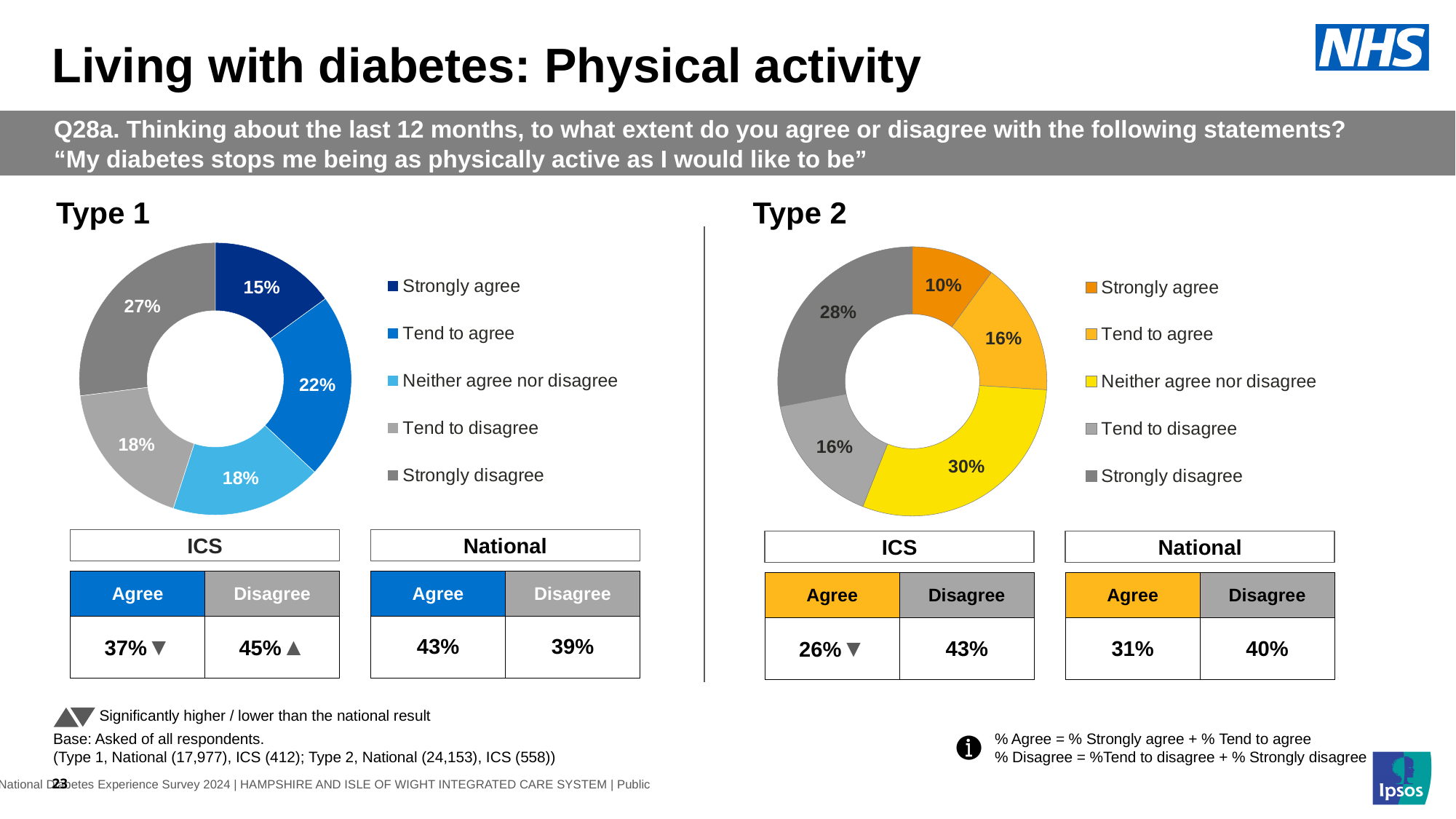
In the Type 1 chart, what percentage of respondents tend to agree? 22% In the Type 1 chart, what percentage of respondents strongly agree? 15% In the Type 1 chart, what is the difference between the Strongly disagree share and the Strongly agree share? 12 percentage points In the Type 2 chart, which is larger: the Neither agree nor disagree share or the Tend to agree share? Neither agree nor disagree In the Type 2 chart, what is the combined share of Strongly agree and Tend to agree? 26% In the Type 1 chart, what colour is the Strongly agree segment? Dark blue What kind of chart is used for the Type 1 results? Donut chart In the Type 2 chart, what percentage of respondents neither agree nor disagree? 30% In the Type 2 chart, what percentage of respondents strongly disagree? 28% How many response categories does the Type 2 chart's legend list? 5 In the Type 2 chart, which response category has the smallest share? Strongly agree In the Type 1 chart, which response category has the largest share? Strongly disagree